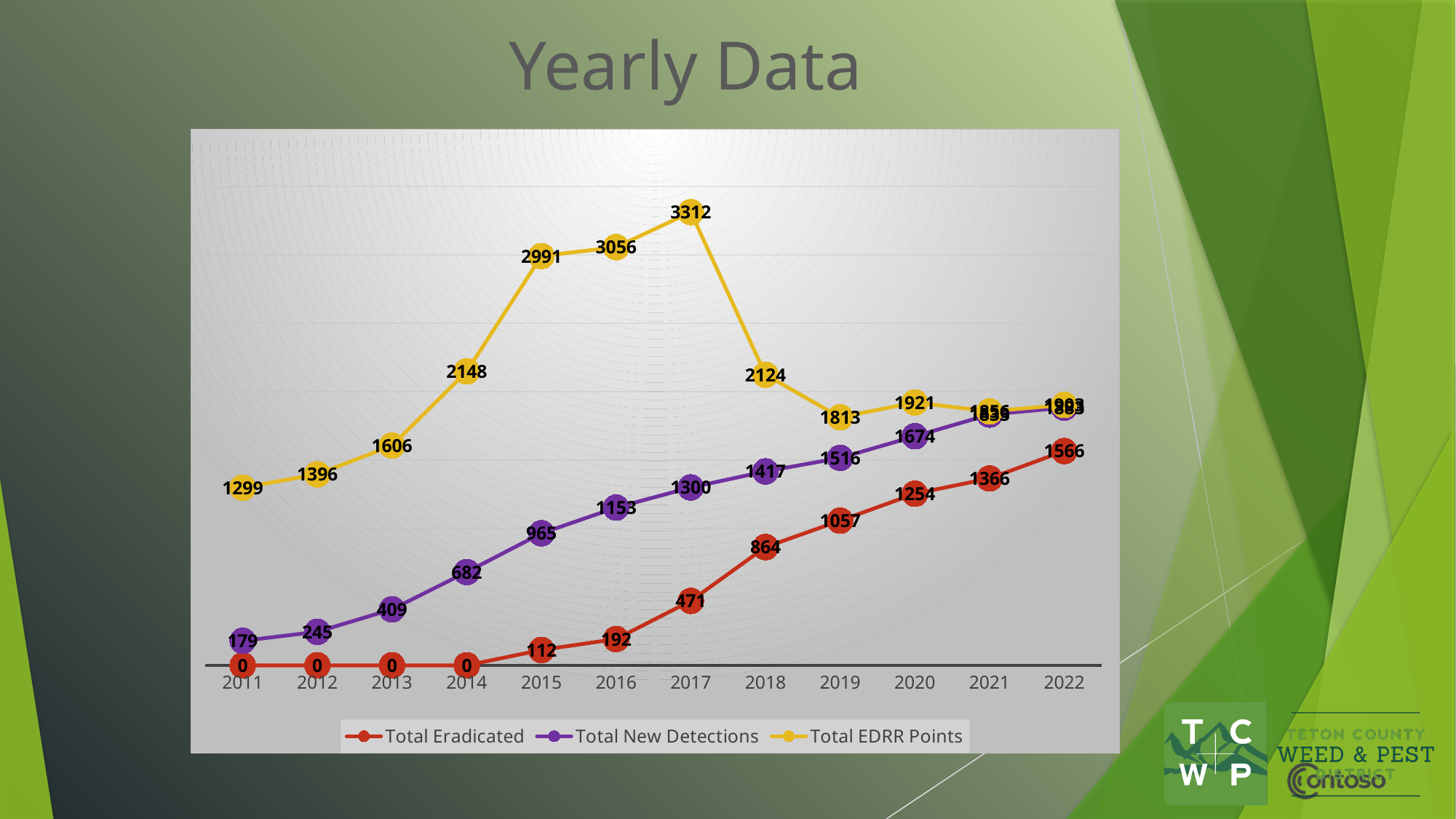
How many years are shown on the x axis? 12 What is the difference between Total EDRR Points in 2017 and 2018? 1188 Does Total Eradicated rise or fall from 2014 to 2022? rise What is the value of Total New Detections in 2015? 965 Which is larger in 2019: Total New Detections or Total Eradicated? Total New Detections What is the value of Total EDRR Points in 2017? 3312 What is the title of the slide? Yearly Data In which year is Total EDRR Points highest? 2017 How many series does the legend list? 3 In which year is Total EDRR Points lowest? 2011 What is the value of Total Eradicated in 2022? 1566 What type of chart is shown on the slide? line chart